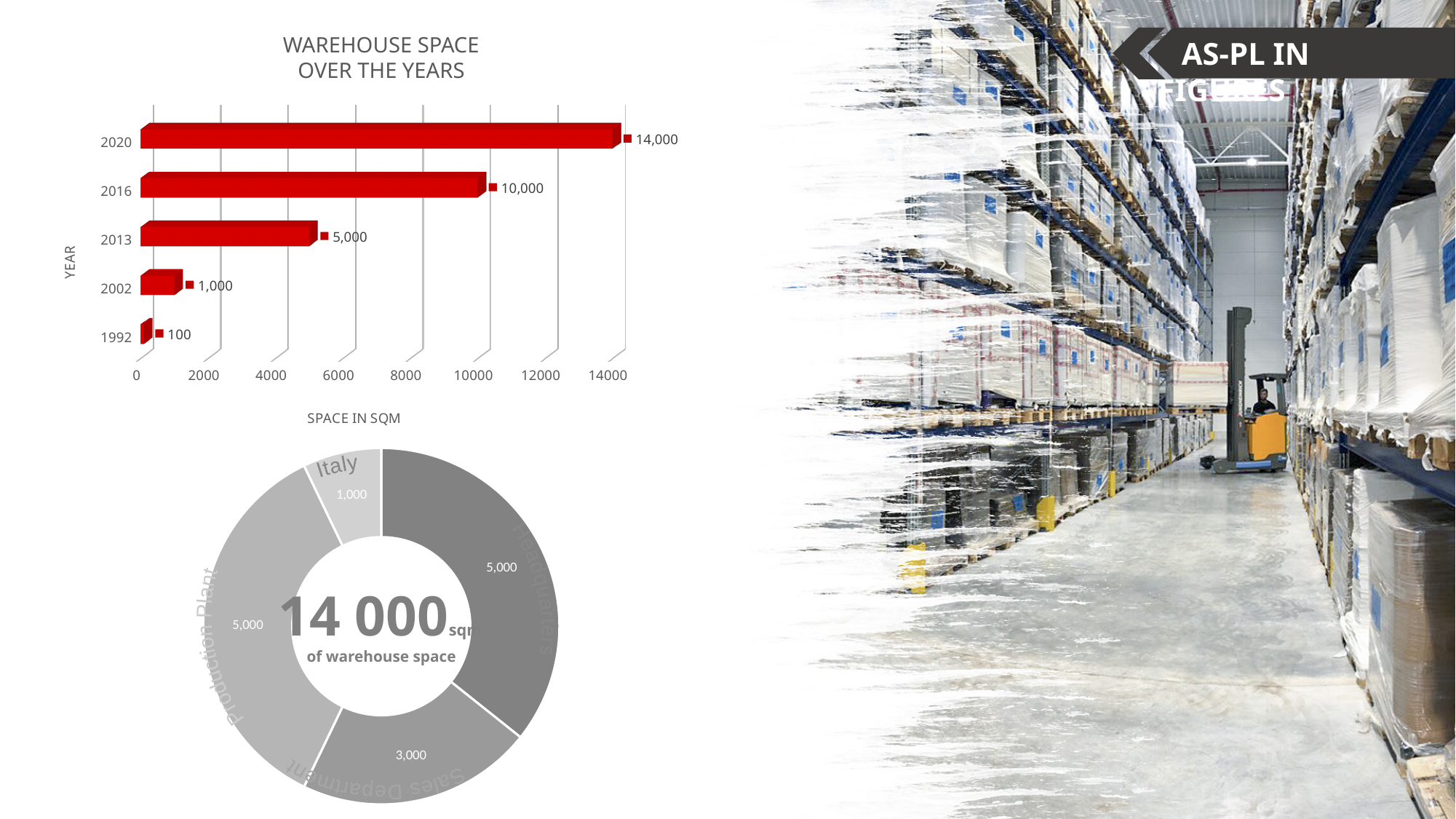
In the donut chart at the bottom left, what is the value for the Sales Department? 3,000 In the 'Warehouse Space Over the Years' chart, which year has the smallest warehouse space? 1992 In the donut chart at the bottom left, what is the value for Italy? 1,000 In the 'Warehouse Space Over the Years' chart, does warehouse space increase or decrease from 1992 to 2020? Increase In the donut chart at the bottom left, what total warehouse space is shown in the centre? 14 000 sqm In the 'Warehouse Space Over the Years' chart, what is the warehouse space for 2020? 14,000 In the 'Warehouse Space Over the Years' chart, how many years are shown? 5 In the donut chart at the bottom left, which is larger, the Production Plant or the Sales Department? Production Plant In the 'Warehouse Space Over the Years' chart, what is the label of the horizontal axis? SPACE IN SQM What type of chart is the 'Warehouse Space Over the Years' chart? Bar chart In the 'Warehouse Space Over the Years' chart, what is the warehouse space for 2002? 1,000 In the 'Warehouse Space Over the Years' chart, what is the difference in warehouse space between 2020 and 2016? 4,000